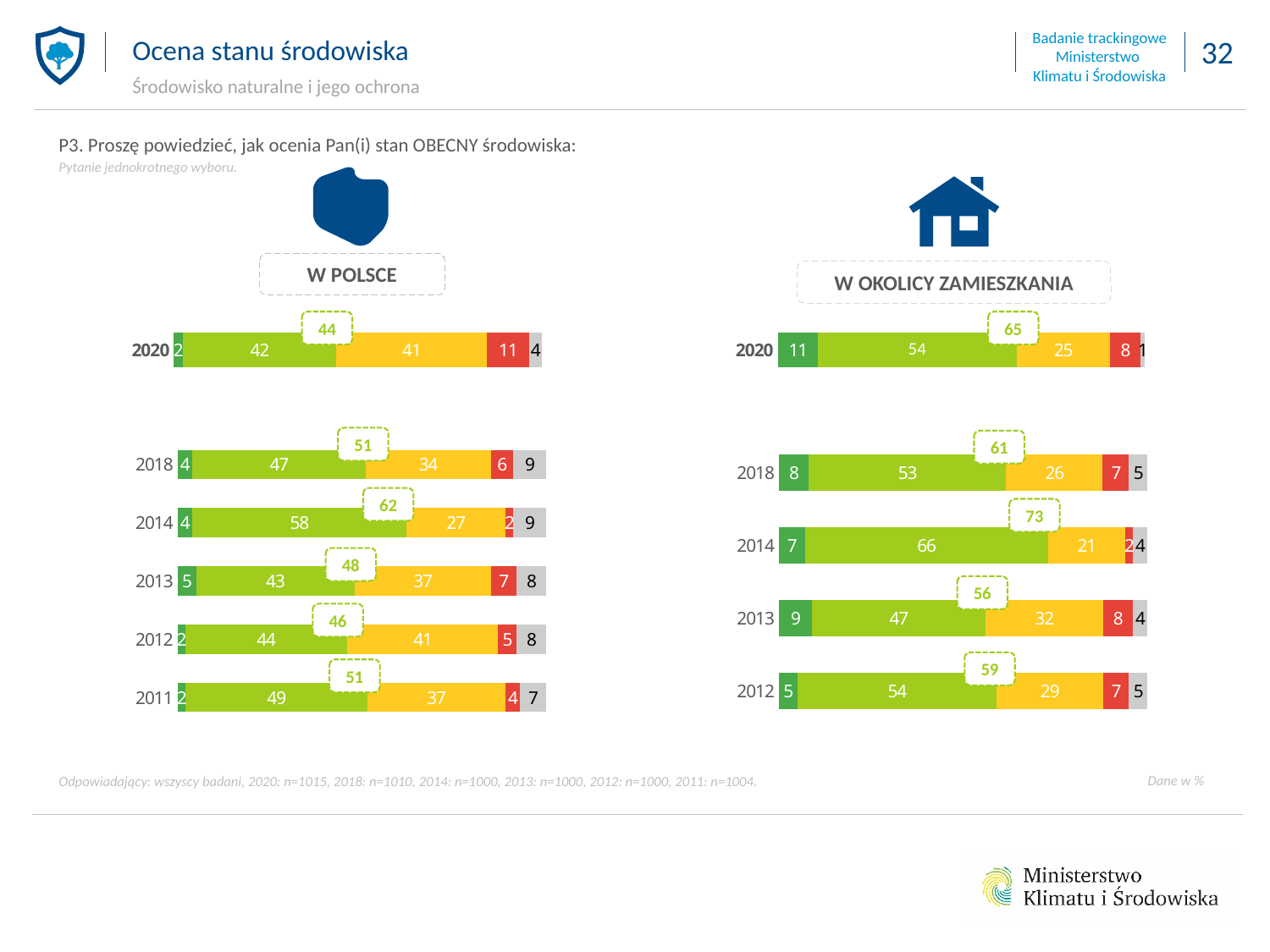
What type of chart is used on this slide? Stacked bar chart In the 'W POLSCE' chart, what is the value of the yellow segment for 2018? 34 In the 'W POLSCE' chart, what is the value of the red segment for 2020? 11 In the 'W OKOLICY ZAMIESZKANIA' chart, what is the value of the light green segment for 2020? 54 How many year bars are shown in the 'W OKOLICY ZAMIESZKANIA' chart? 5 In the 'W POLSCE' chart, what is the difference between the callout values for 2014 and 2020? 18 How many year bars are shown in the 'W POLSCE' chart? 6 In the 'W OKOLICY ZAMIESZKANIA' chart, what value is shown in the dashed callout above the 2014 bar? 73 In the 'W OKOLICY ZAMIESZKANIA' chart, which is larger: the light green segment for 2014 or for 2013? 2014 In the 'W OKOLICY ZAMIESZKANIA' chart, which year has the lowest dashed callout value? 2013 In the 'W POLSCE' chart, what value is shown in the dashed callout above the 2020 bar? 44 In the 'W POLSCE' chart, which year has the highest dashed callout value? 2014